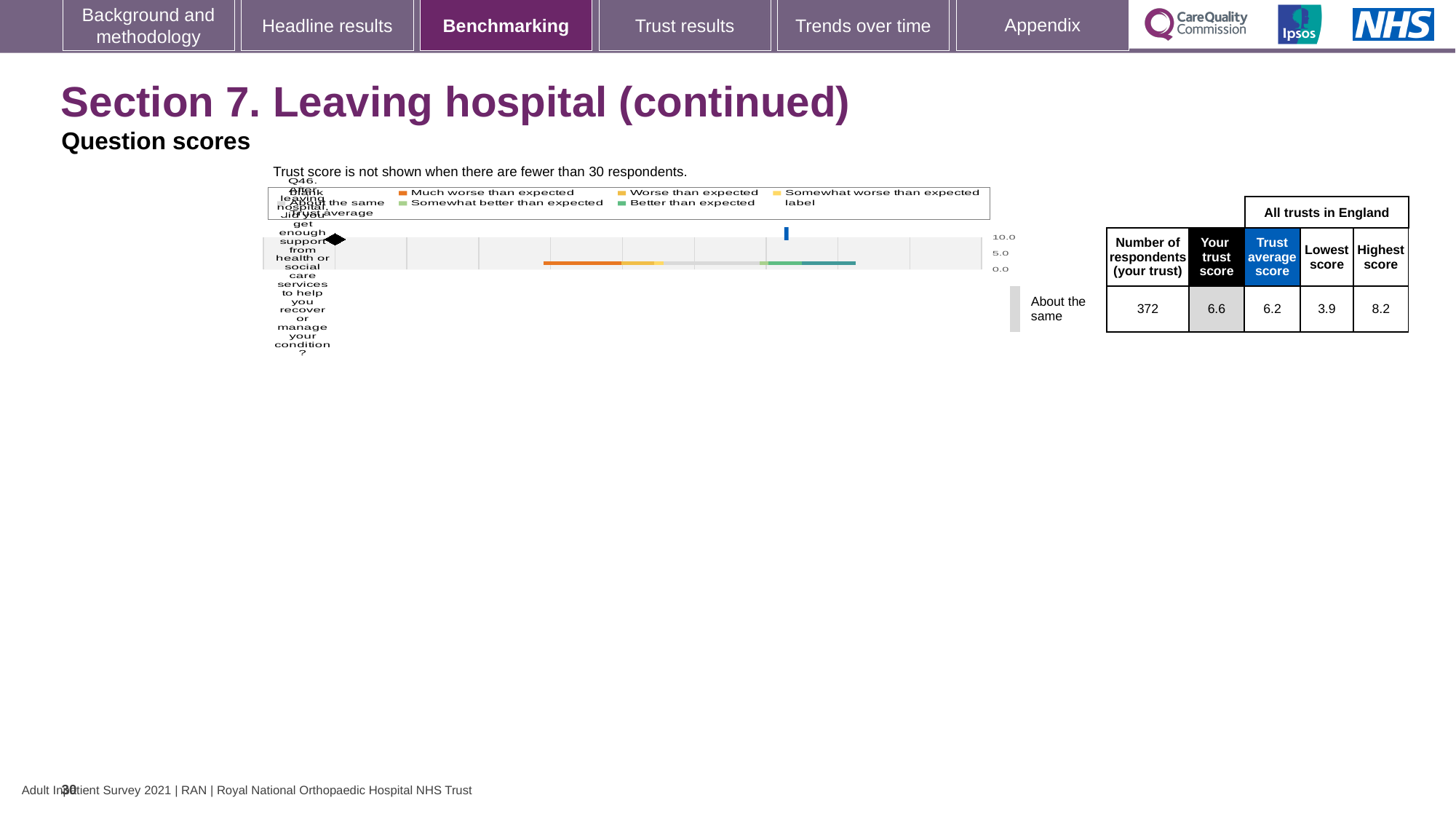
What is the lowest score among all trusts in England for Q46? 3.9 Is the trust score for Q46 greater or less than 5.0 on the chart axis? greater What is the trust score for Q46 shown on the slide? 6.6 Is the trust score for Q46 higher or lower than the trust average score? higher What benchmarking category is the trust's Q46 result labelled as? About the same What is the difference between the trust score and the trust average score for Q46? 0.4 What is the highest score among all trusts in England for Q46? 8.2 How many respondents from the trust answered Q46? 372 What is the maximum value shown on the chart's axis? 10.0 What is the difference between the highest and lowest scores among all trusts in England for Q46? 4.3 What kind of chart is used to show the Q46 benchmarking result? bar chart What is the trust average score for Q46 across all trusts in England? 6.2